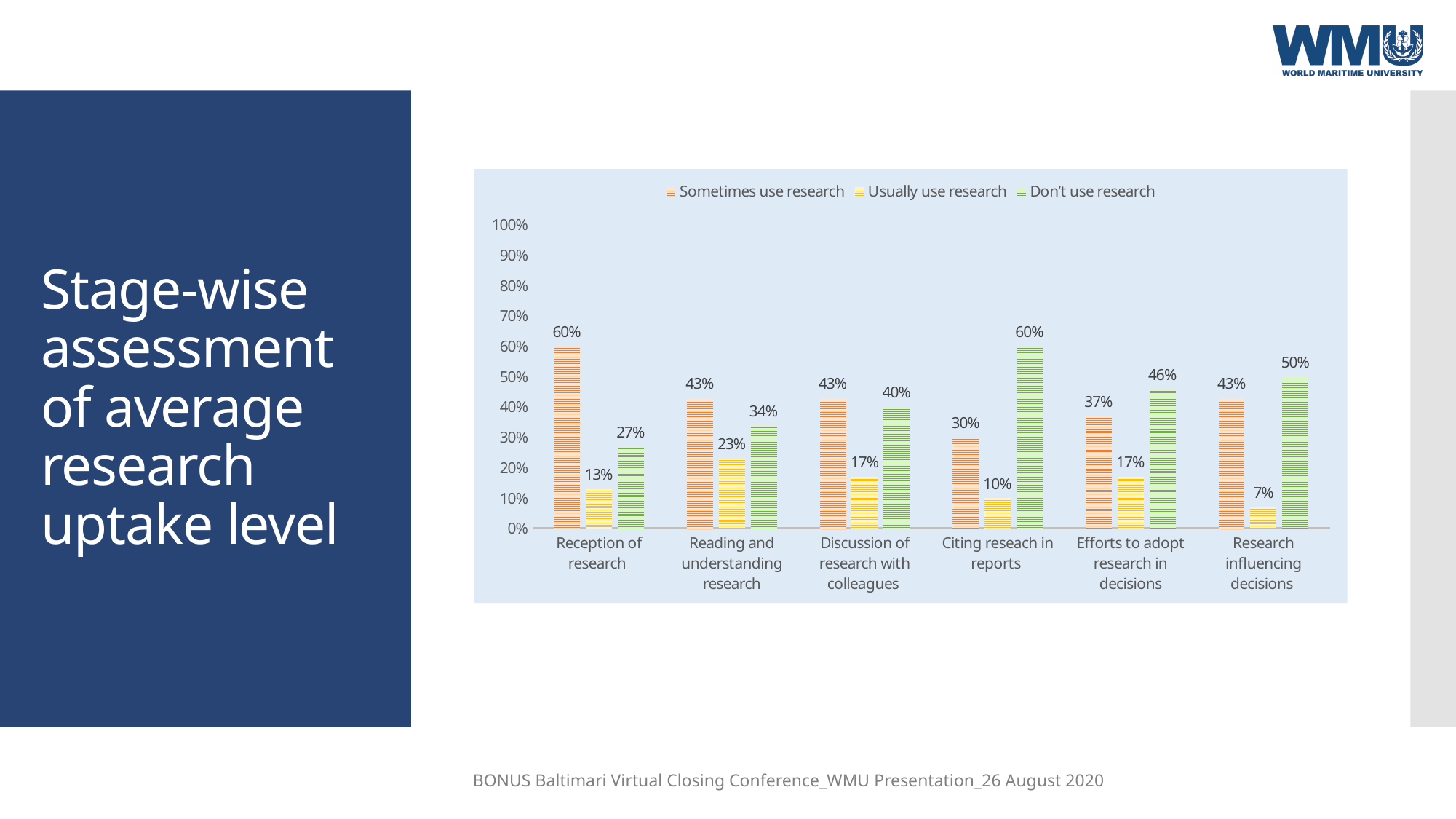
What kind of chart is shown on the slide? Bar chart Which series is shown in green in the legend? Don't use research How many series does the legend list? 3 Does the "Sometimes use research" series rise or fall from "Reception of research" to "Citing reseach in reports"? Fall What is the value for "Don't use research" in the "Citing reseach in reports" category? 60% Which category has the highest value for "Usually use research"? Reading and understanding research In the "Efforts to adopt research in decisions" category, which is larger: "Sometimes use research" or "Don't use research"? Don't use research What is the value for "Usually use research" in the "Research influencing decisions" category? 7% What is the value for "Sometimes use research" in the "Reception of research" category? 60% What is the difference between "Don't use research" and "Sometimes use research" in the "Citing reseach in reports" category? 30% How many categories are shown on the x axis? 6 Which category has the lowest value for "Don't use research"? Reception of research